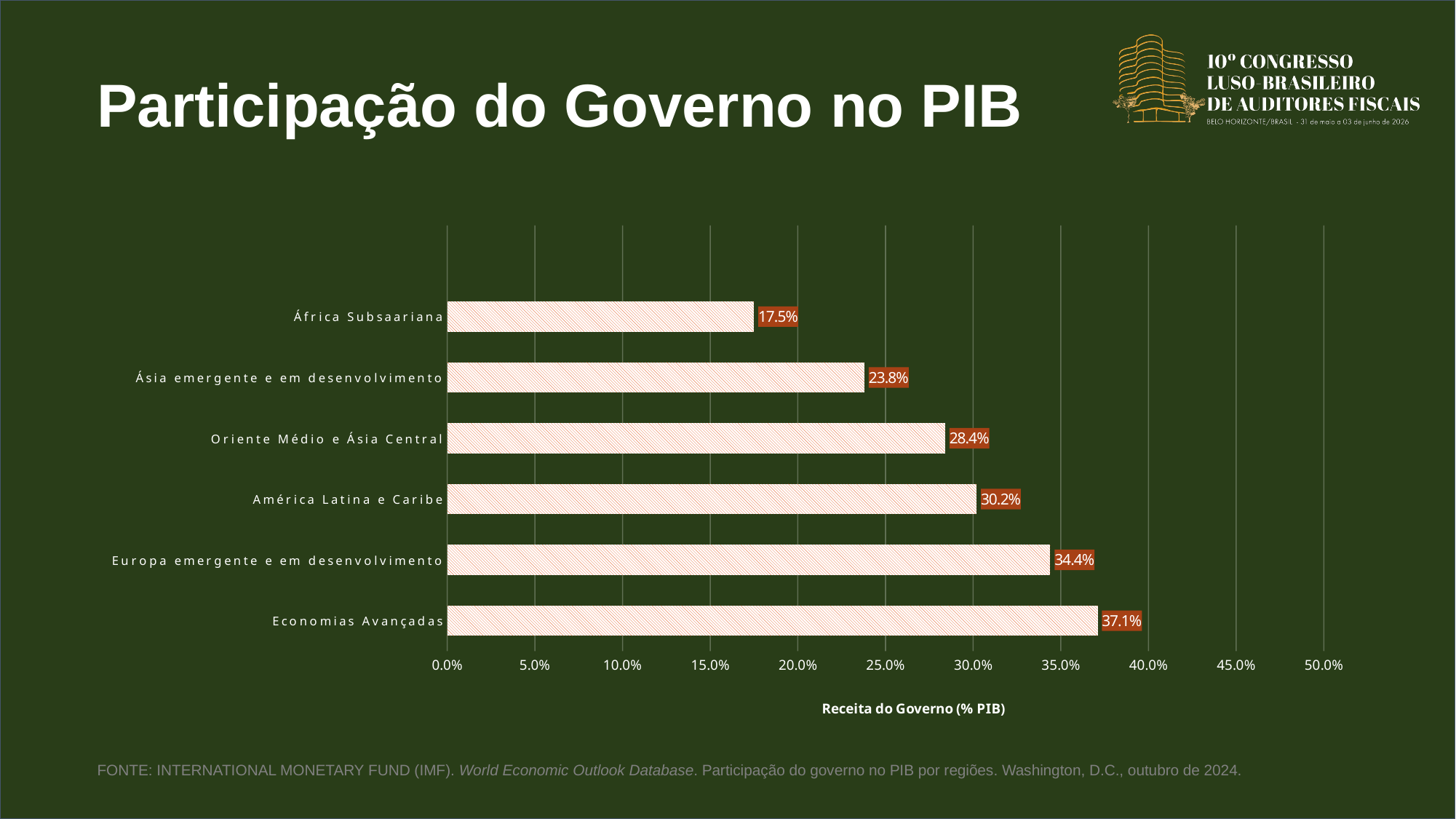
What kind of chart is shown on the slide? bar chart What is the value for Economias Avançadas? 37.1% Which region has the highest government revenue as a share of GDP? Economias Avançadas What is the difference between Economias Avançadas and África Subsaariana? 19.6% What is the value for América Latina e Caribe? 30.2% What is the difference between Europa emergente e em desenvolvimento and Oriente Médio e Ásia Central? 6.0% What is the label of the horizontal axis? Receita do Governo (% PIB) Which is larger, the value for Ásia emergente e em desenvolvimento or the value for Oriente Médio e Ásia Central? Oriente Médio e Ásia Central What is the value for África Subsaariana? 17.5% Is the value for Europa emergente e em desenvolvimento greater or less than 30.0%? greater How many regions are shown in the chart? 6 Which region has the lowest government revenue as a share of GDP? África Subsaariana